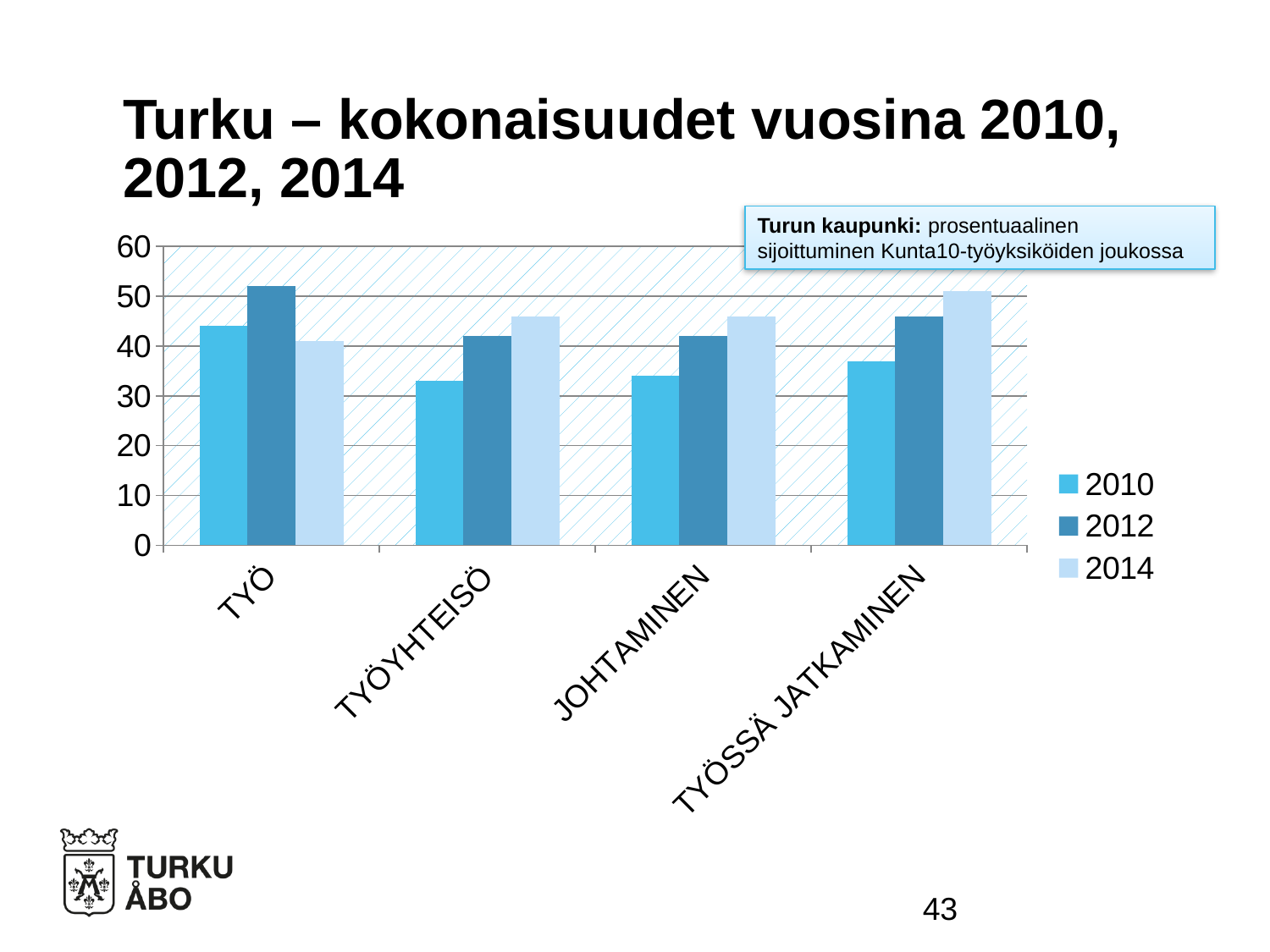
Which category has the lowest 2010 value? TYÖYHTEISÖ Which category has the highest 2012 value? TYÖ For TYÖ, which is larger: the 2012 value or the 2014 value? 2012 Which years are listed in the legend? 2010, 2012, 2014 Is the value for TYÖ in 2012 greater or less than 50? greater Is the value for JOHTAMINEN in 2010 greater or less than 40? less Is the value for TYÖYHTEISÖ in 2010 greater or less than 40? less Do the values for TYÖSSÄ JATKAMINEN rise or fall from 2010 to 2014? rise How many series does the legend list? 3 How many categories are shown on the x axis? 4 What kind of chart is shown on the slide? bar chart